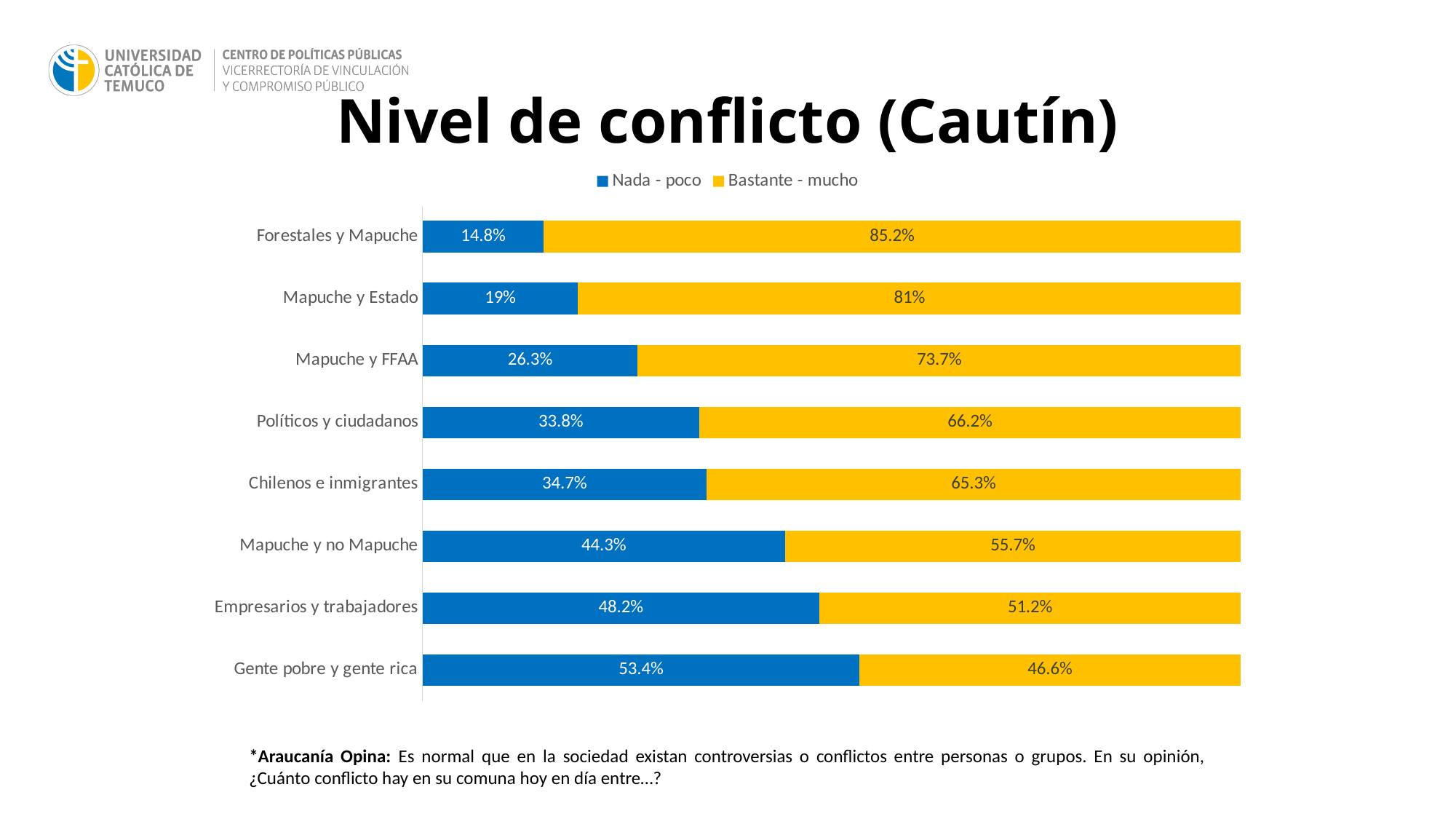
What is the 'Bastante - mucho' value for Forestales y Mapuche? 85.2% How many series does the legend list? 2 What is the title of the chart? Nivel de conflicto (Cautín) Which category has the lowest 'Nada - poco' value? Forestales y Mapuche What is the 'Nada - poco' value for Mapuche y Estado? 19% Which category has the highest 'Nada - poco' value? Gente pobre y gente rica What is the 'Bastante - mucho' value for Empresarios y trabajadores? 51.2% How many categories are shown in the chart? 8 What is the difference between the 'Bastante - mucho' values for Mapuche y FFAA and Mapuche y no Mapuche? 18% What kind of chart is shown on the slide? Stacked bar chart Which is larger: the 'Nada - poco' value for Políticos y ciudadanos or for Mapuche y no Mapuche? Mapuche y no Mapuche Which category has the highest 'Bastante - mucho' value? Forestales y Mapuche